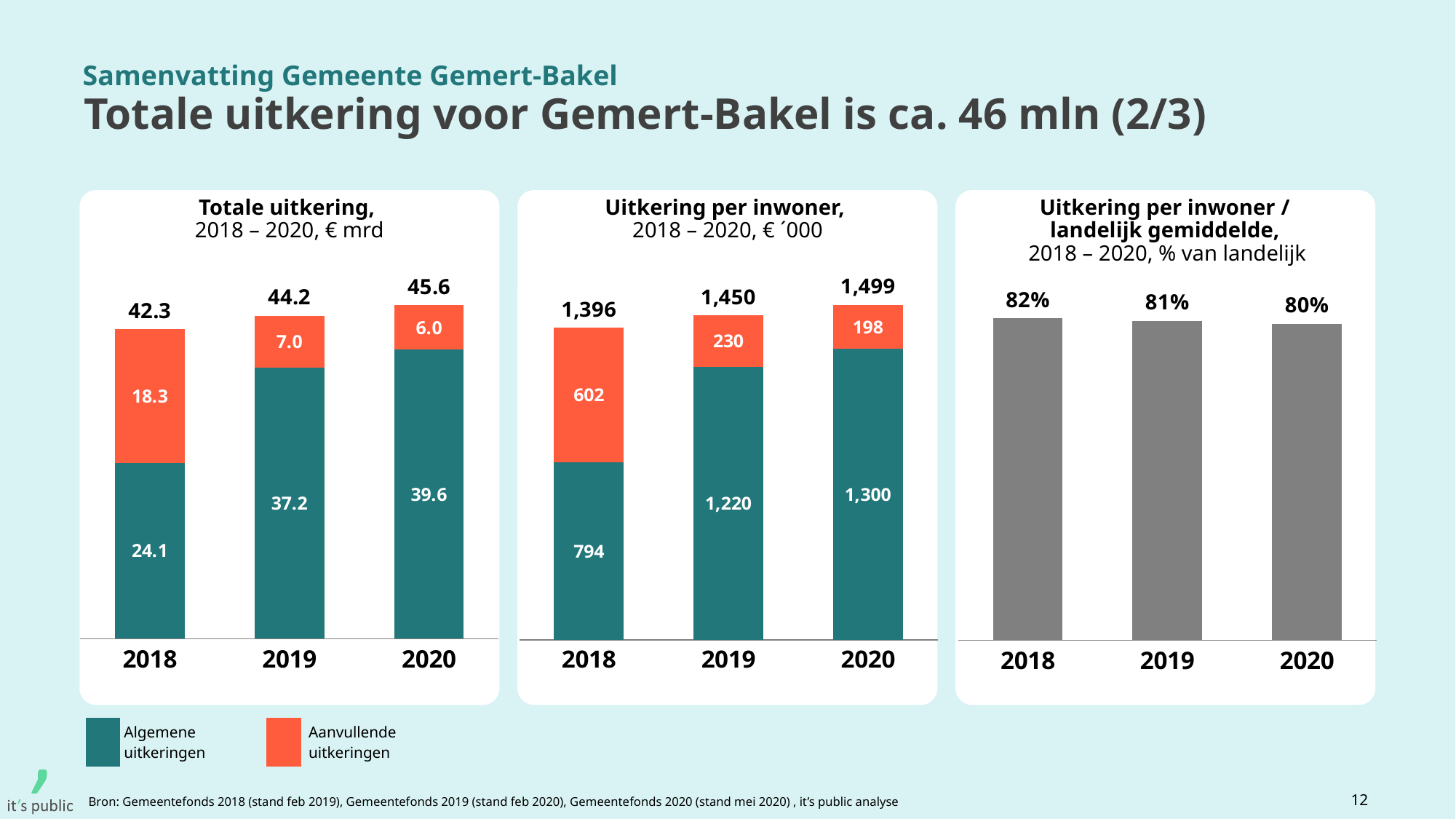
In the 'Uitkering per inwoner' chart, what is the value of Aanvullende uitkeringen for 2019? 230 What kind of chart is the 'Uitkering per inwoner / landelijk gemiddelde' chart? bar chart In the 'Totale uitkering' chart, which year has the highest total? 2020 In the 'Totale uitkering' chart, what is the value of Algemene uitkeringen for 2018? 24.1 In the 'Uitkering per inwoner' chart, what is the difference between the Algemene uitkeringen values for 2020 and 2018? 506 In the 'Uitkering per inwoner / landelijk gemiddelde' chart, what is the value for 2019? 81% In the 'Uitkering per inwoner' chart, which is larger: Algemene uitkeringen in 2019 or in 2020? 2020 How many series does the legend at the bottom of the slide list? 2 In the 'Uitkering per inwoner' chart, what is the total of the stacked bar for 2018? 1,396 In the 'Uitkering per inwoner / landelijk gemiddelde' chart, do the values rise or fall from 2018 to 2020? fall In the 'Totale uitkering' chart, what is the difference between the Aanvullende uitkeringen values for 2018 and 2019? 11.3 In the 'Totale uitkering' chart, what is the total of the stacked bar for 2020? 45.6